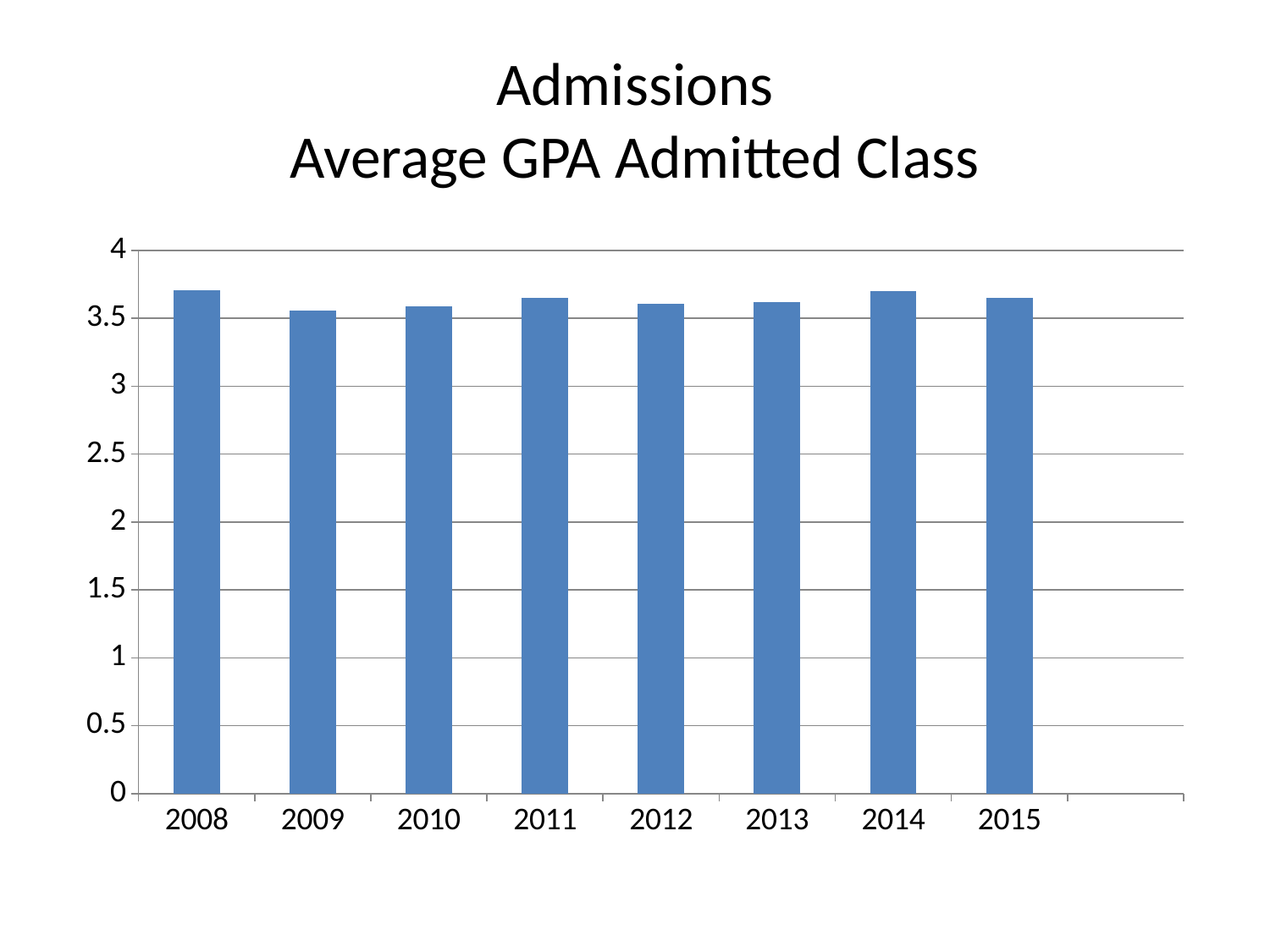
What is the first year shown on the x axis? 2008 Is the value for 2012 greater or less than 3? greater Is the value for 2008 greater or less than 3.5? greater Is the value for 2015 greater or less than 3.5? greater What kind of chart is shown on the slide? bar chart Which is larger, the value for 2008 or the value for 2009? 2008 How many years are shown on the x axis of the chart? 8 Which is larger, the value for 2014 or the value for 2012? 2014 Which is larger, the value for 2009 or the value for 2011? 2011 What is the title of the chart? Admissions Average GPA Admitted Class